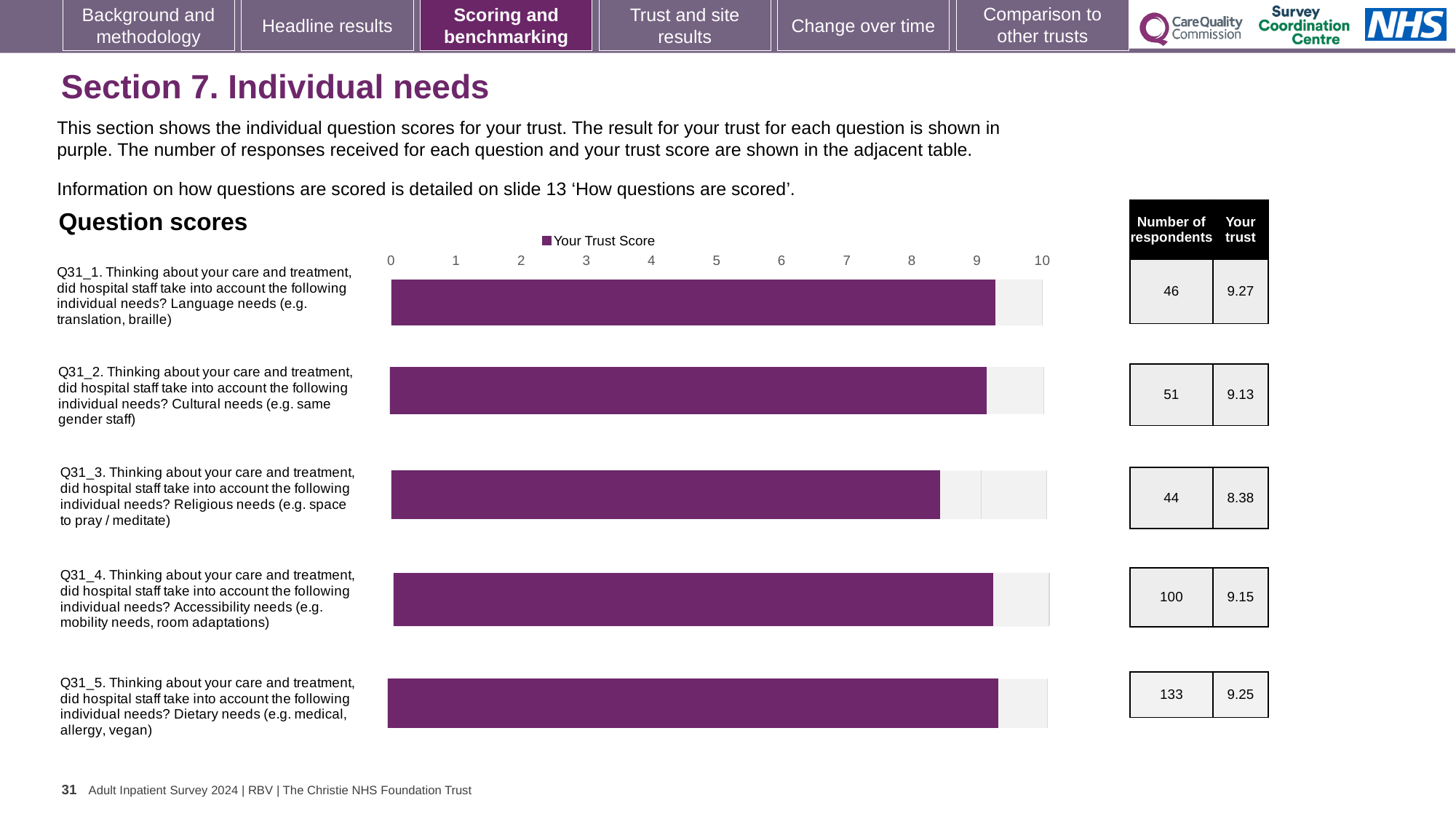
Which question has the lowest trust score? Q31_3 (Religious needs) What is the trust score for Q31_1 (Language needs)? 9.27 How many questions are plotted in the chart? 5 What is the name of the series shown in the chart legend? Your Trust Score Is the trust score for Q31_3 (Religious needs) greater or less than 9? less What type of chart is shown on the slide? Bar chart Which has a higher trust score, Q31_2 (Cultural needs) or Q31_3 (Religious needs)? Q31_2 (Cultural needs) What is the difference between the trust scores for Q31_1 (Language needs) and Q31_3 (Religious needs)? 0.89 Which question has the highest trust score? Q31_1 (Language needs) What is the trust score for Q31_3 (Religious needs)? 8.38 What is the trust score for Q31_5 (Dietary needs)? 9.25 How many series does the chart legend list? 1